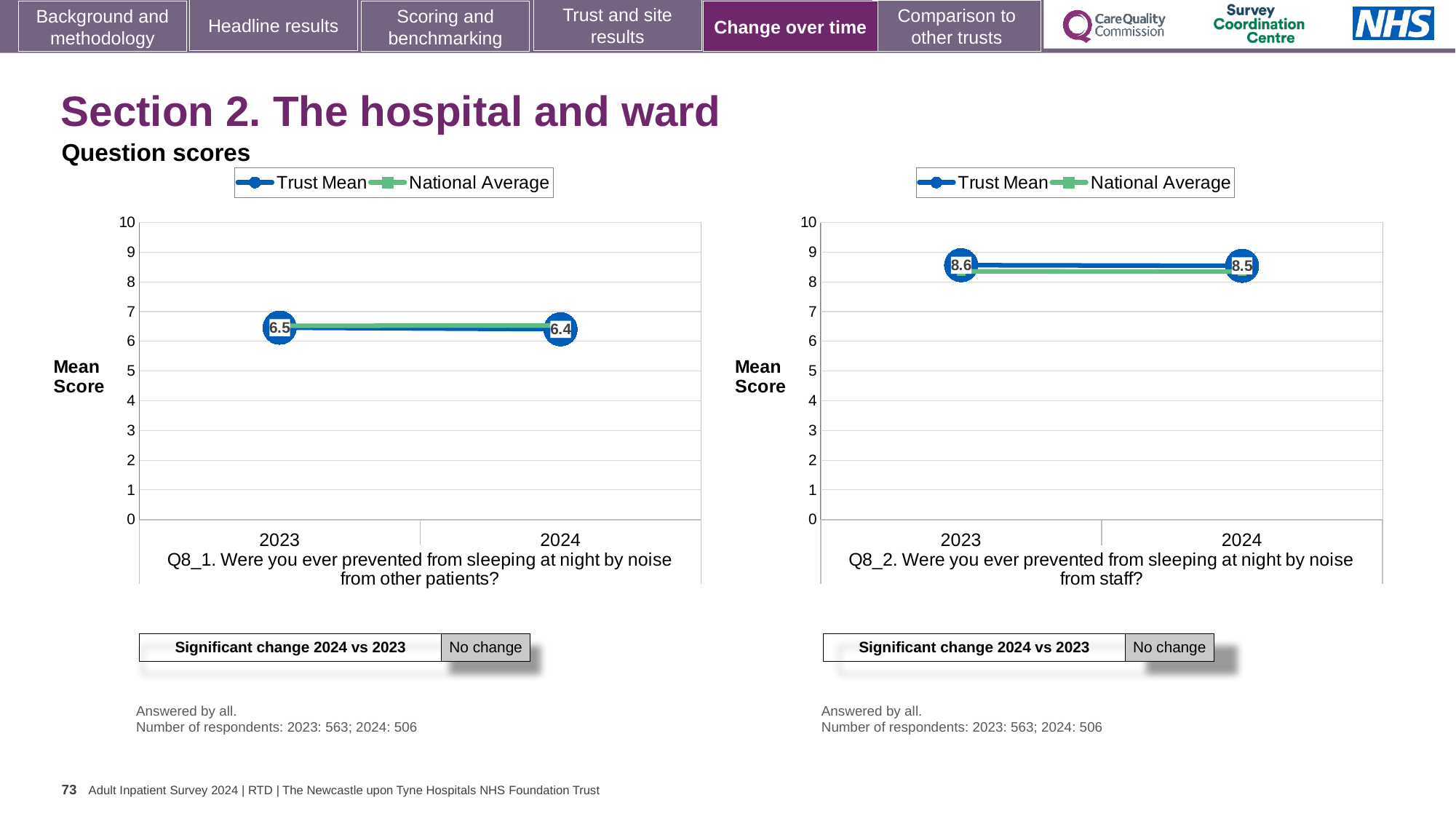
In the left chart (Q8_1), what is the Trust Mean score for 2024? 6.4 In the right chart (Q8_2), does the Trust Mean rise or fall from 2023 to 2024? Fall In the right chart (Q8_2), what is the Trust Mean score for 2024? 8.5 In the right chart (Q8_2), which year has the higher Trust Mean score, 2023 or 2024? 2023 How many series does the legend of the left chart (Q8_1) list? 2 In the left chart (Q8_1), what is the difference between the Trust Mean scores for 2023 and 2024? 0.1 How many years are plotted on the x axis of the left chart (Q8_1)? 2 What kind of chart is the right chart (Q8_2)? Line chart In the left chart (Q8_1), what is the Trust Mean score for 2023? 6.5 In the right chart (Q8_2), is the National Average value for 2023 greater or less than 7? greater In the left chart (Q8_1), is the National Average value for 2024 greater or less than 5? greater In the right chart (Q8_2), what is the Trust Mean score for 2023? 8.6